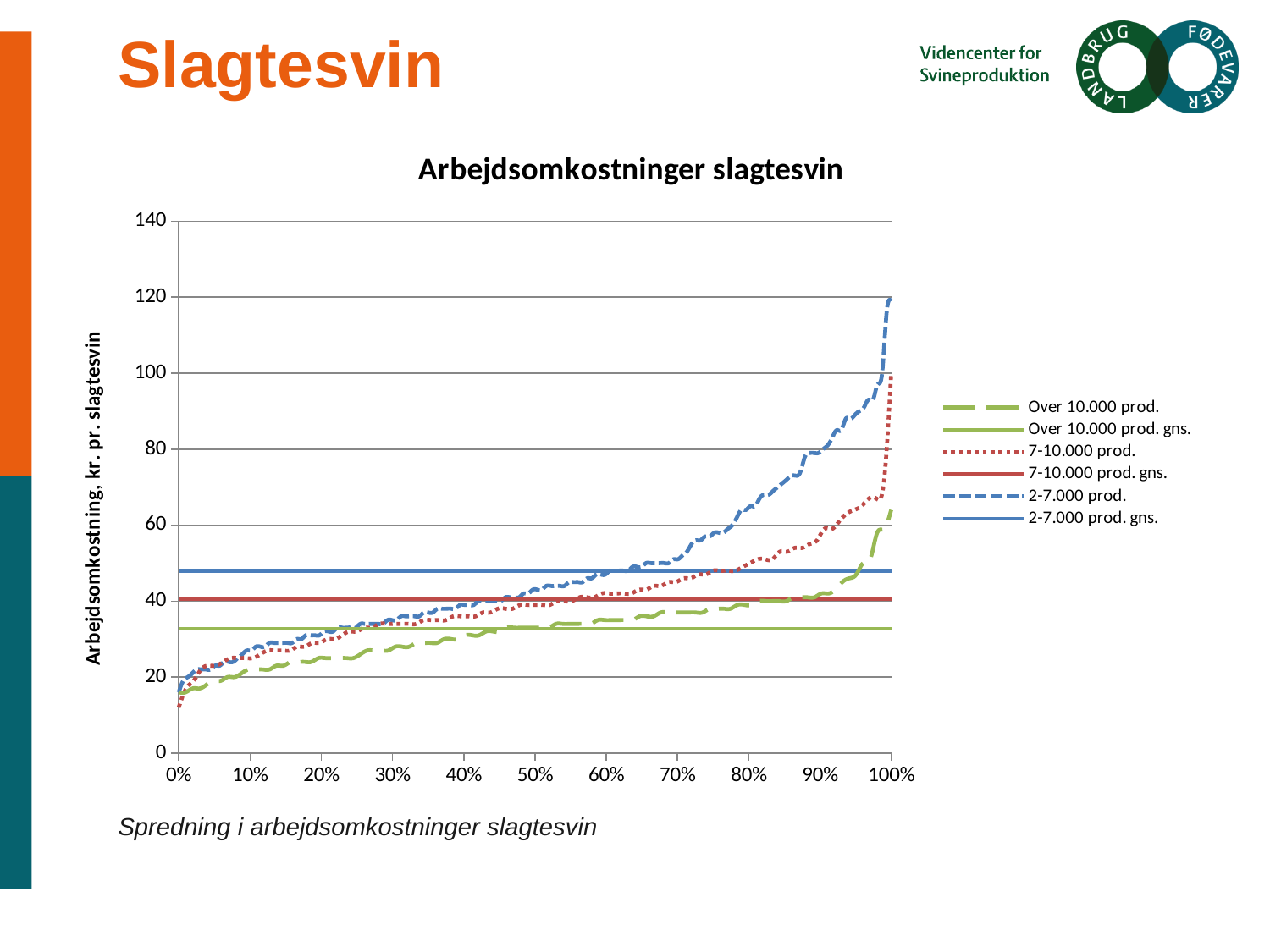
What kind of chart is shown on the slide? line chart Is the 2-7.000 prod. gns. line greater or less than 60? less Which of the three average (gns.) lines is the highest? 2-7.000 prod. gns. Do the dashed and dotted production lines rise or fall as the x axis goes from 0% to 100%? rise What is the label on the vertical axis of the chart? Arbejdsomkostning, kr. pr. slagtesvin Is the value of the 2-7.000 prod. line at 100% greater or less than 100? greater At 100%, which is higher: the 2-7.000 prod. line or the Over 10.000 prod. line? 2-7.000 prod. Is the Over 10.000 prod. gns. line greater or less than 40? less What is the title of the chart? Arbejdsomkostninger slagtesvin Which of the three average (gns.) lines is the lowest? Over 10.000 prod. gns. How many series does the legend list? 6